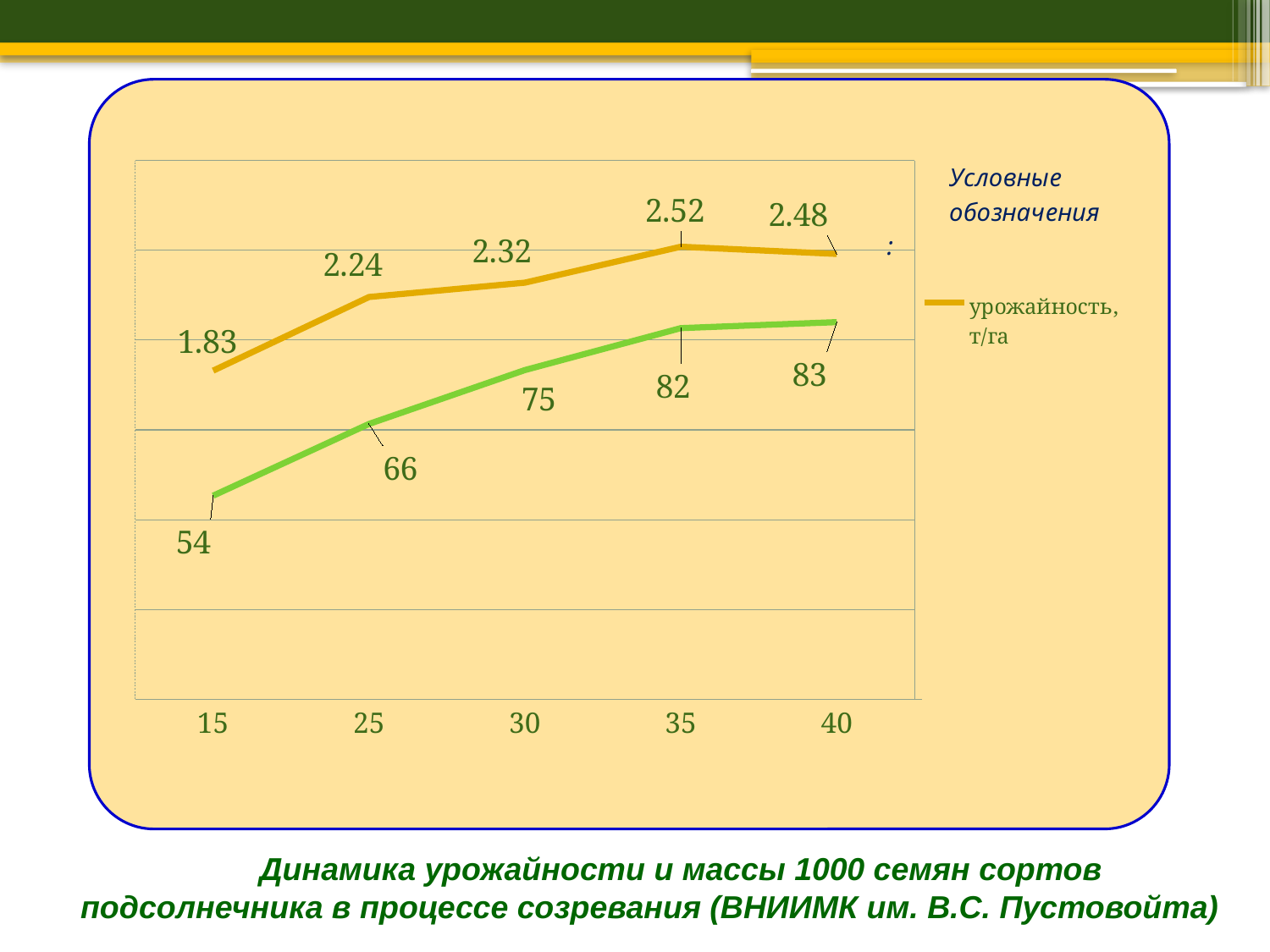
At which x value does урожайность, т/га (orange line) reach its highest value? 35 What is the value of урожайность, т/га (orange line) at x = 15? 1.83 How many x-axis points are plotted on the chart? 5 Does the green line rise or fall from x = 15 to x = 40? rise What is the value of the green line at x = 40? 83 What is the value of урожайность, т/га (orange line) at x = 30? 2.32 What type of chart is shown on the slide? line chart What is the difference between the highest and lowest values of урожайность, т/га (orange line)? 0.69 Which is larger for урожайность, т/га: the value at x = 35 or at x = 40? 35 At which x value is урожайность, т/га (orange line) lowest? 15 By how much does the green line increase from x = 15 to x = 40? 29 What is the value of the green line at x = 25? 66